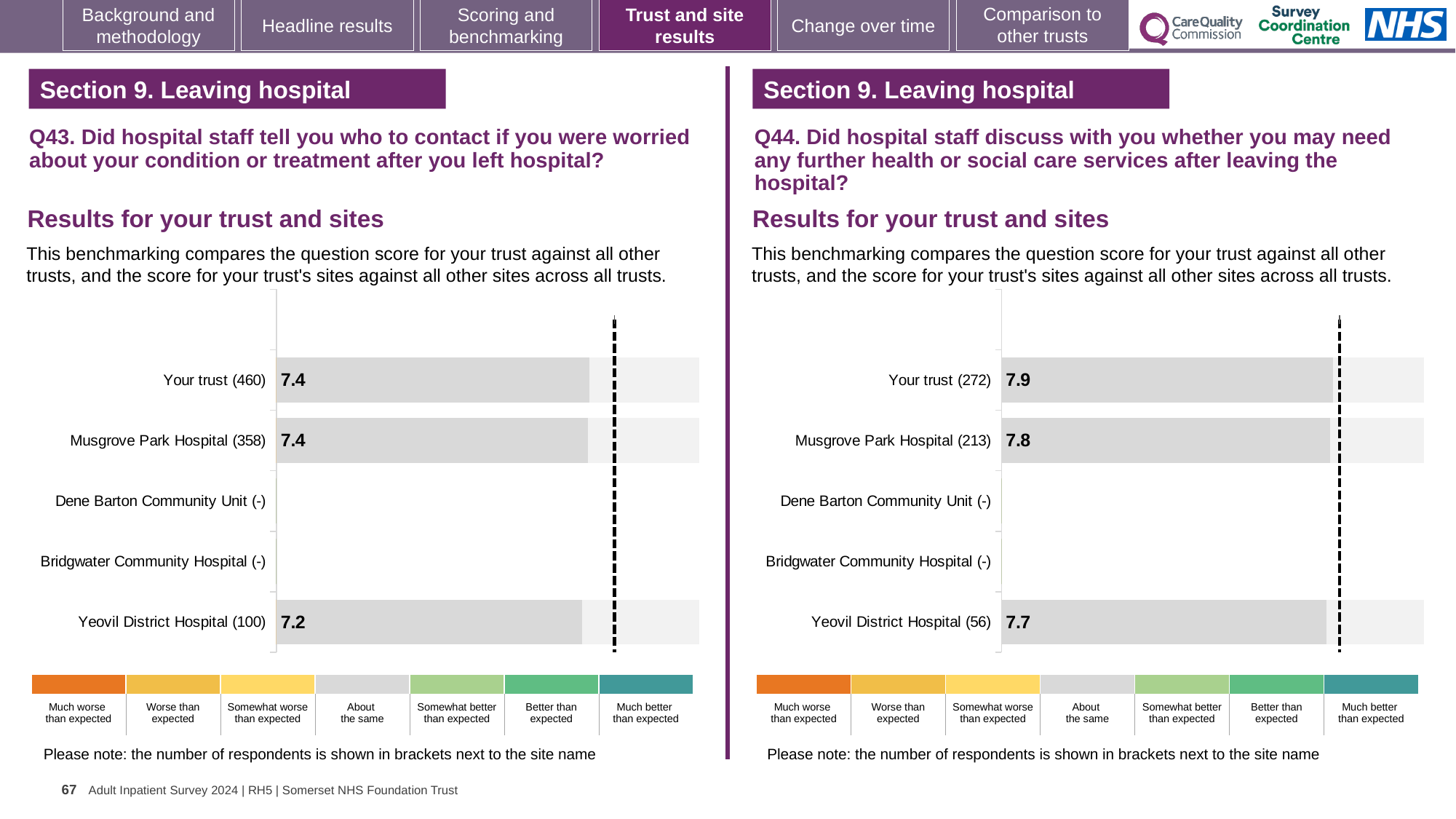
In the Q44 chart on the right, is the score for Your trust (272) larger or smaller than the score for Musgrove Park Hospital (213)? larger In the Q43 chart on the left, what is the score for Yeovil District Hospital (100)? 7.2 In the Q44 chart on the right, what is the difference between the score for Your trust (272) and Yeovil District Hospital (56)? 0.2 In the Q44 chart on the right, what is the score for Musgrove Park Hospital (213)? 7.8 How many rows (sites or trust) are listed in the Q43 chart on the left? 5 In the Q44 chart on the right, what is the score for Yeovil District Hospital (56)? 7.7 In the Q44 chart on the right, which site or trust has the lowest score? Yeovil District Hospital (56) What kind of chart is used in the Q44 chart on the right? bar chart In the Q43 chart on the left, which site or trust has the lowest score? Yeovil District Hospital (100) In the Q44 chart on the right, what is the score for Your trust (272)? 7.9 In the Q43 chart on the left, what is the difference between the score for Musgrove Park Hospital (358) and Yeovil District Hospital (100)? 0.2 In the Q43 chart on the left, what is the score for Your trust (460)? 7.4